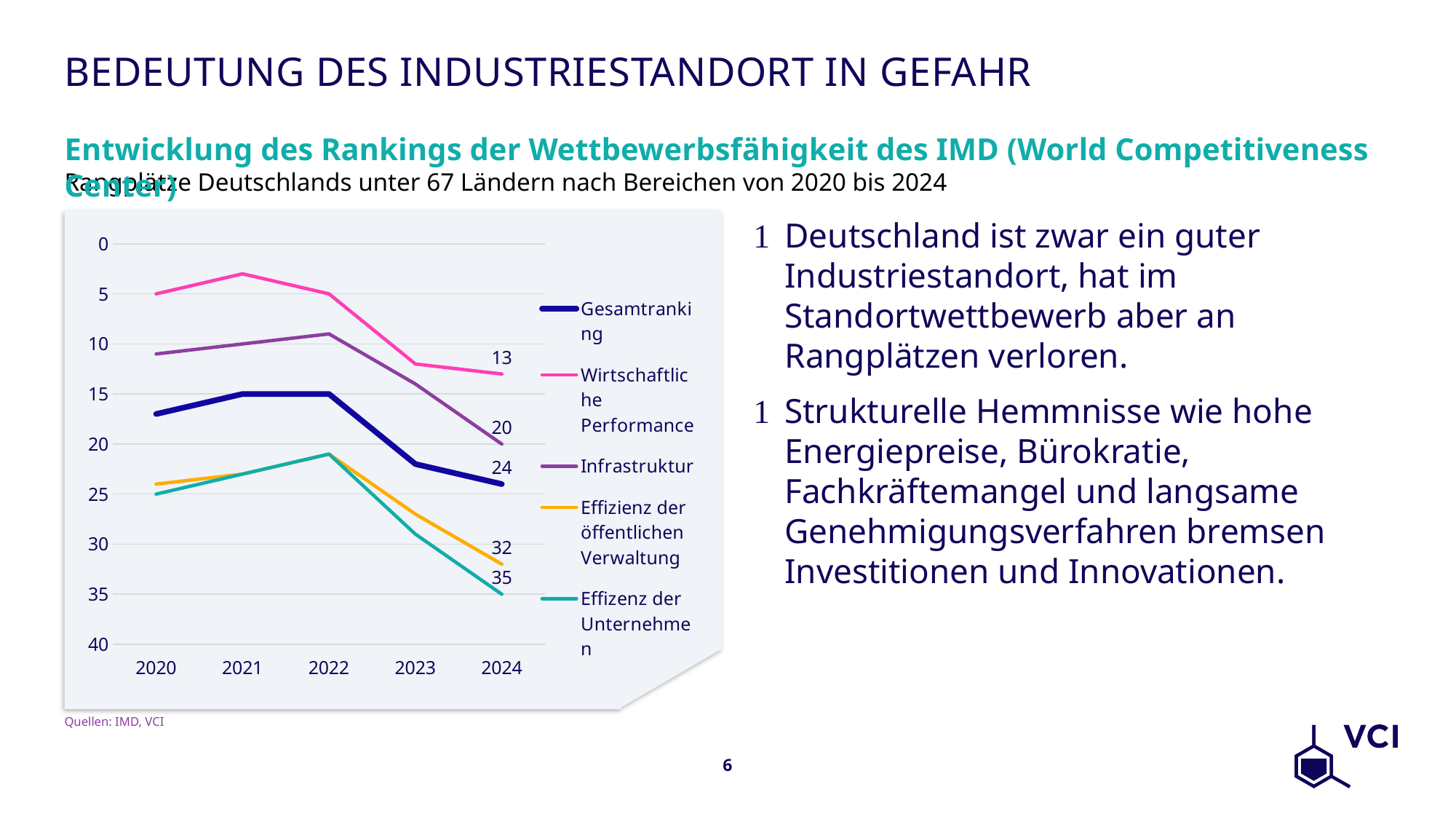
What is the value for Gesamtranking in 2024? 24 What is the value for Wirtschaftliche Performance in 2024? 13 What is the value for Effizienz der öffentlichen Verwaltung in 2024? 32 What sources are cited below the chart? IMD, VCI What is the difference between the 2024 values for Effizenz der Unternehmen and Wirtschaftliche Performance? 22 Which series has the larger value in 2024, Infrastruktur or Gesamtranking? Gesamtranking How many years are shown on the x axis? 5 What is the value for Infrastruktur in 2024? 20 Is the value for Gesamtranking in 2020 greater or less than 15? greater What kind of chart is shown on the slide? line chart How many series does the legend list? 5 What is the value for Effizenz der Unternehmen in 2024? 35